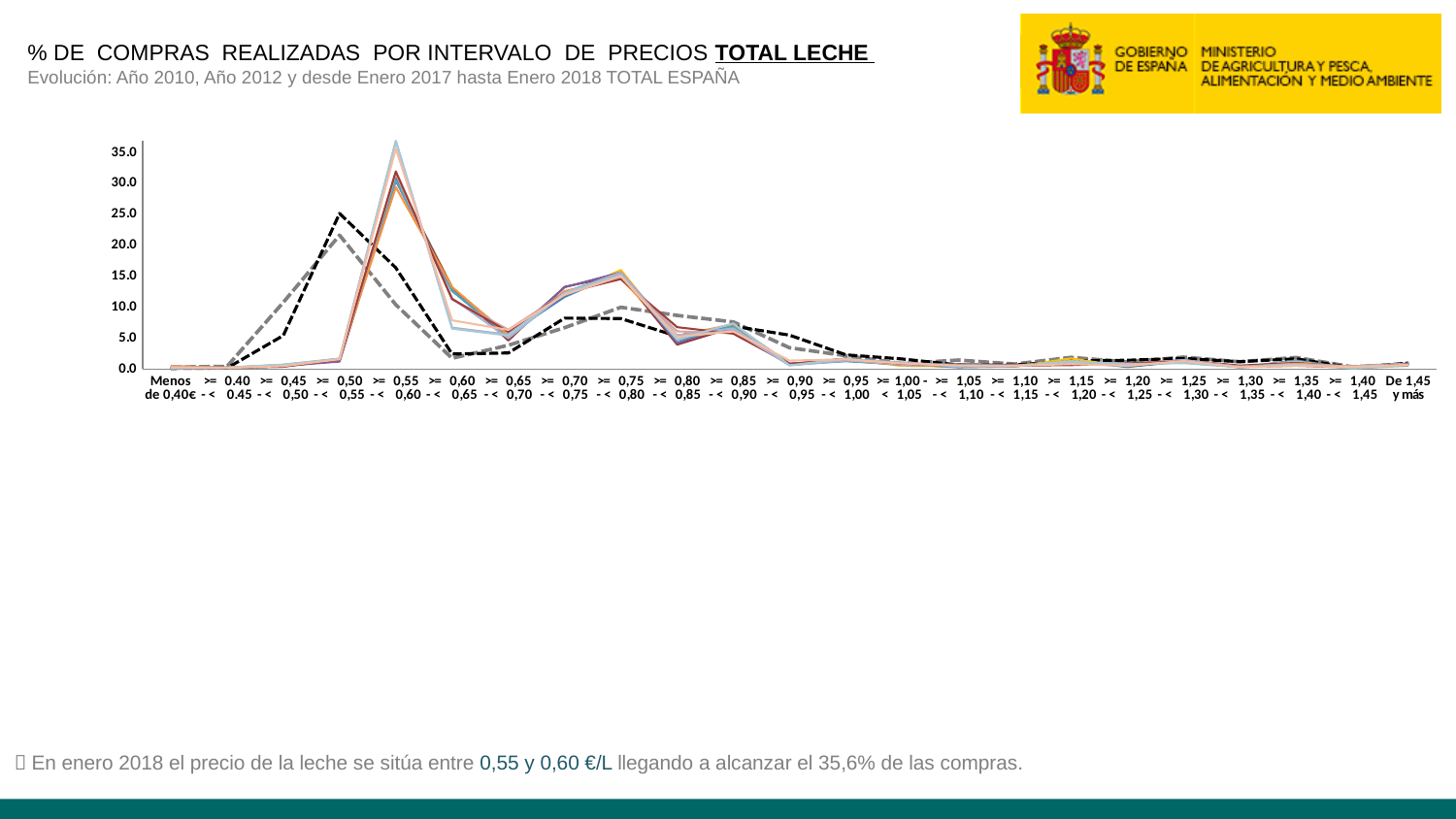
What is the highest tick value shown on the y axis of the chart? 35.0 What is the label of the last category on the x axis of the chart? De 1,45 y más In which price interval does the chart reach its highest peak? >= 0,55 - < 0,60 Are the values plotted for the interval >= 1,00 - < 1,05 greater or less than 5.0? less Is the highest point plotted on the chart greater or less than 30.0? greater Do the solid lines rise or fall between the interval >= 0,65 - < 0,70 and the interval >= 0,75 - < 0,80? rise What is the title of the chart on the slide? % DE COMPRAS REALIZADAS POR INTERVALO DE PRECIOS TOTAL LECHE How many price intervals are shown along the x axis of the chart? 23 Are the values plotted for the category 'Menos de 0,40€' greater or less than 5.0? less What kind of chart is shown on the slide? line chart Do the lines rise or fall between the interval >= 0,55 - < 0,60 and the interval >= 0,65 - < 0,70? fall